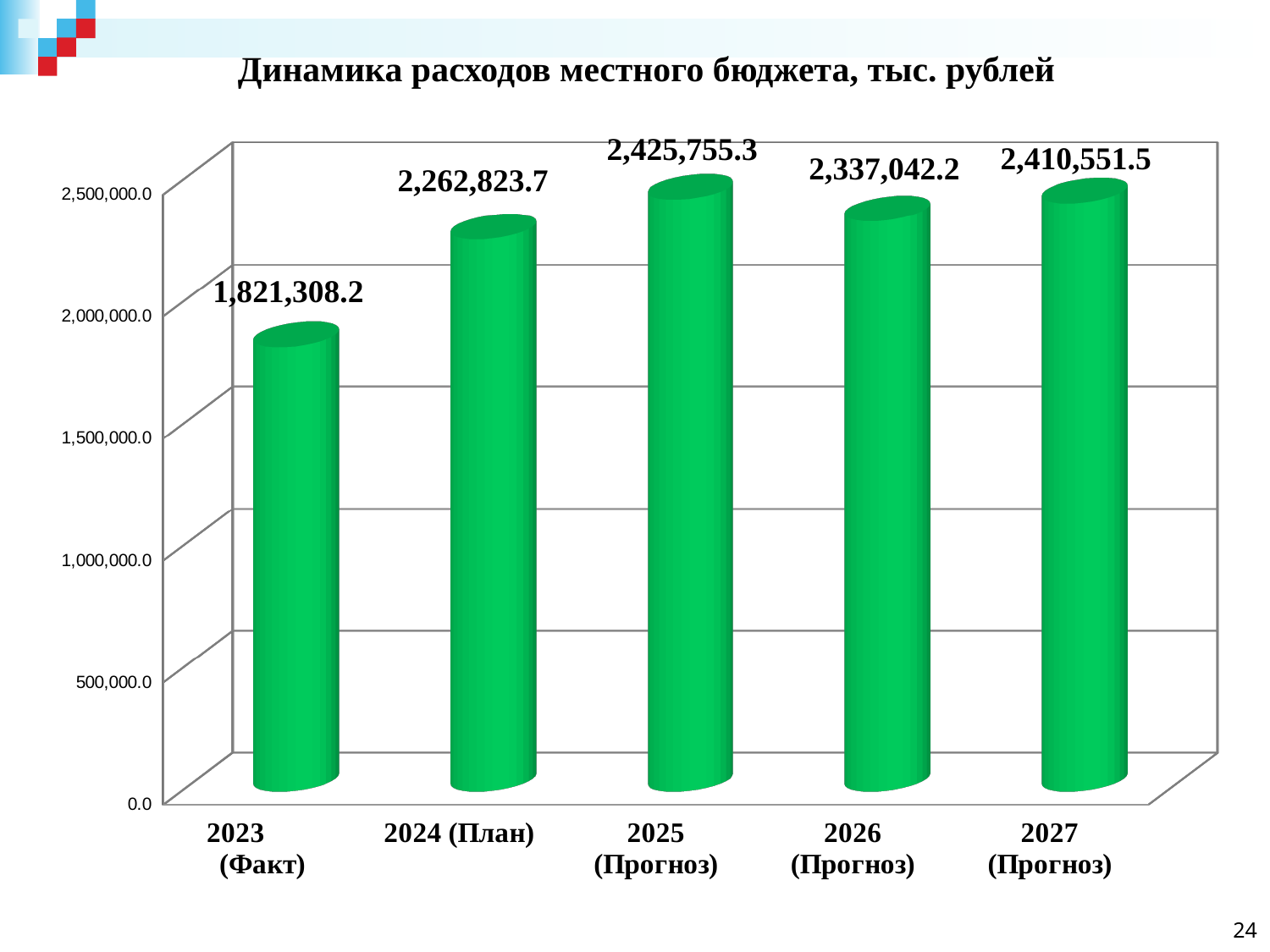
What is the value for 2023 (Факт)? 1,821,308.2 What is the title of the chart? Динамика расходов местного бюджета, тыс. рублей What is the difference between the values for 2025 (Прогноз) and 2026 (Прогноз)? 88,713.1 What is the difference between the values for 2024 (План) and 2023 (Факт)? 441,515.5 What kind of chart is shown on the slide? Bar chart What is the value for 2026 (Прогноз)? 2,337,042.2 Which is larger, the value for 2025 (Прогноз) or 2027 (Прогноз)? 2025 (Прогноз) What is the value for 2024 (План)? 2,262,823.7 Which category has the highest value? 2025 (Прогноз) What is the value for 2027 (Прогноз)? 2,410,551.5 How many categories are shown on the x axis? 5 Which category has the lowest value? 2023 (Факт)